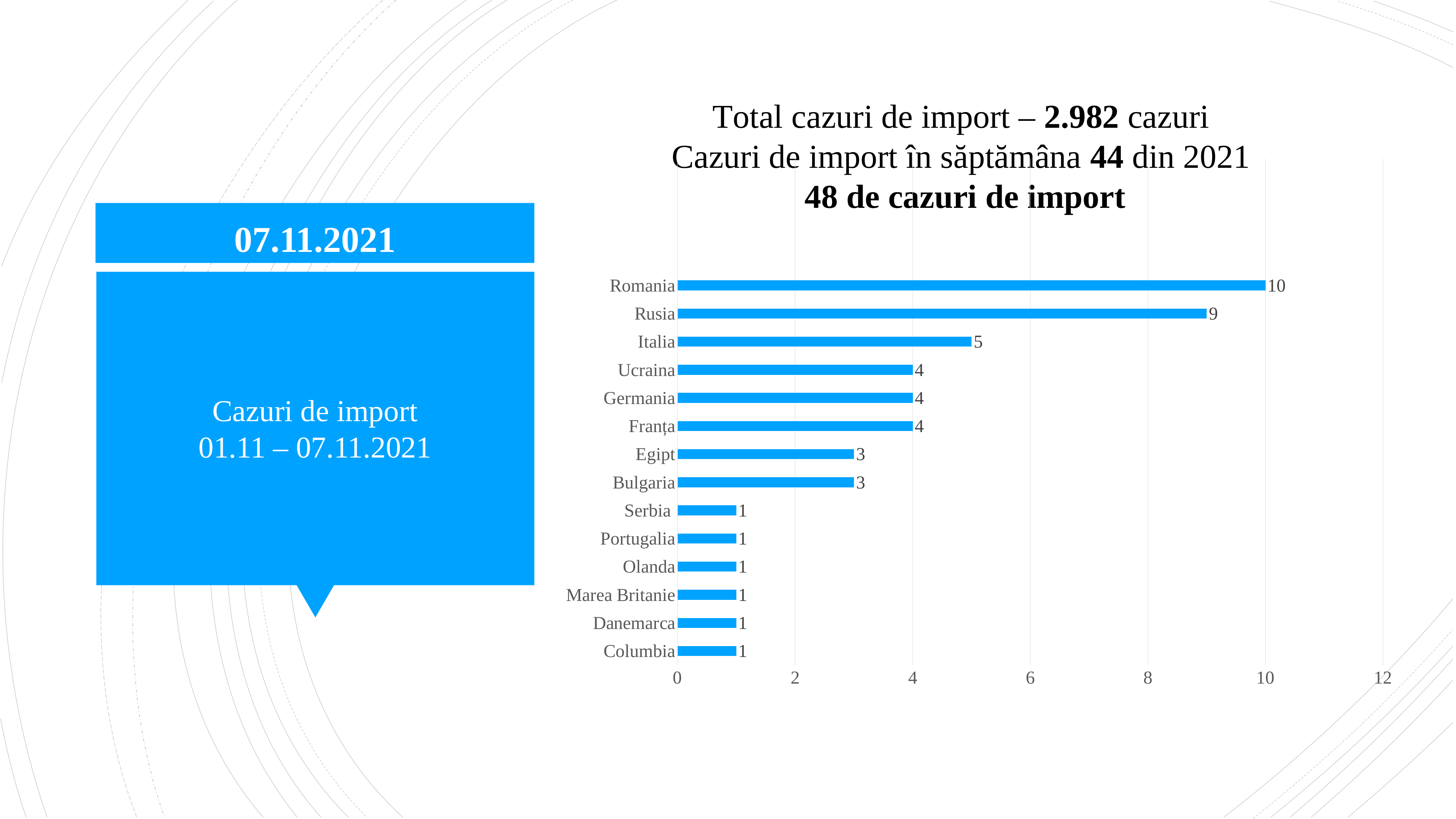
What is the difference between the values for Italia and Bulgaria? 2 How many countries are shown in the chart? 14 What is the value for Italia? 5 What is the value for Romania? 10 What is the value for Marea Britanie? 1 What type of chart is shown on the slide? bar chart Which country has the highest value? Romania What is the value for Egipt? 3 What is the difference between the values for Romania and Rusia? 1 Which is larger, the value for Rusia or the value for Ucraina? Rusia Is the value for Rusia greater or less than 8? greater What is the highest value shown on the x axis? 12